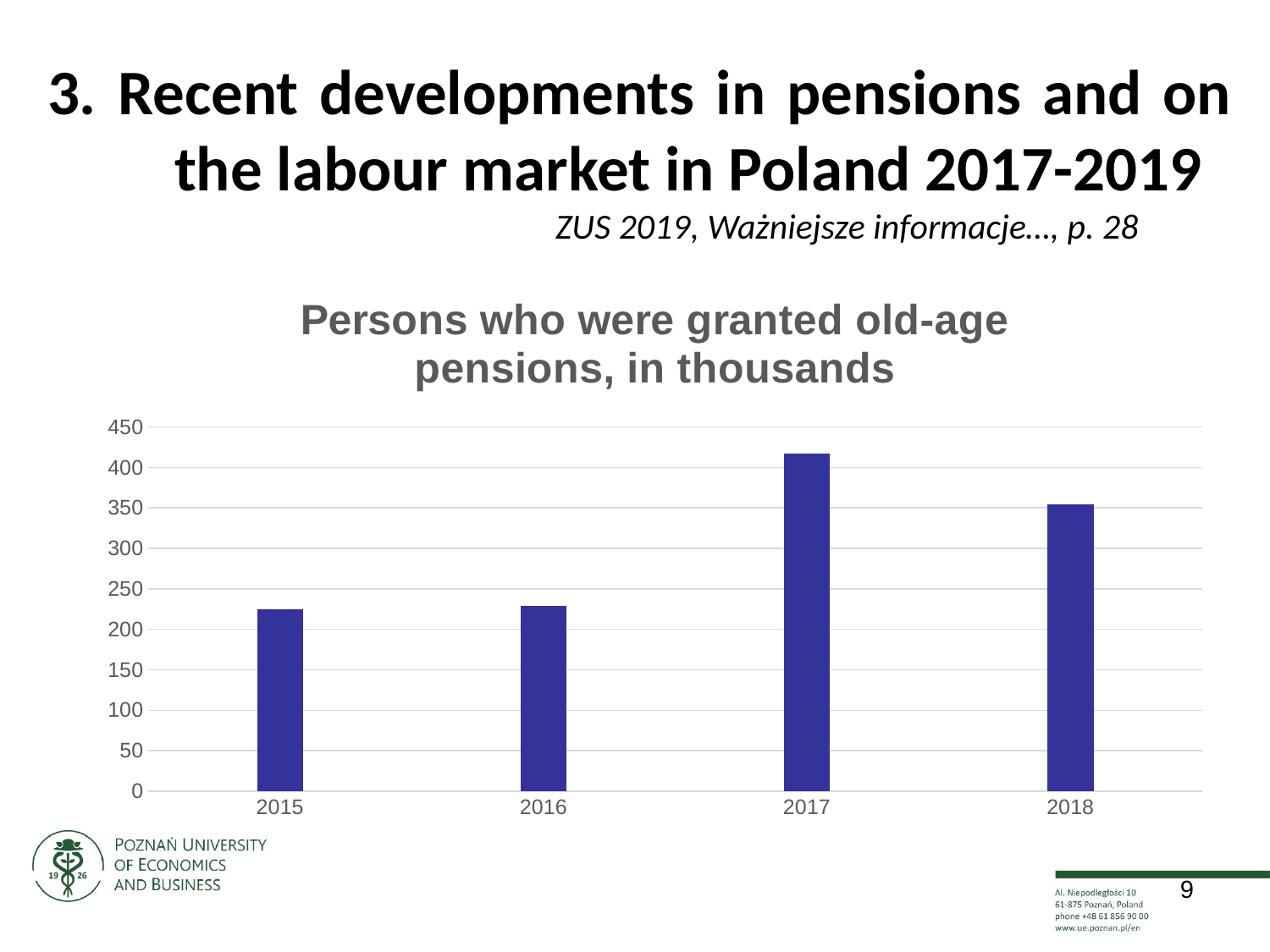
What is the title of the chart? Persons who were granted old-age pensions, in thousands Is the value for 2018 greater or less than 400? less Is the value for 2017 greater or less than 400? greater Is the value for 2018 greater or less than 300? greater Which is larger, the value for 2015 or the value for 2018? 2018 Which is larger, the value for 2017 or the value for 2018? 2017 Which year has the highest value in the chart? 2017 Did the value rise or fall from 2017 to 2018? fall How many years are shown on the x axis of the chart? 4 What kind of chart is shown on the slide? bar chart